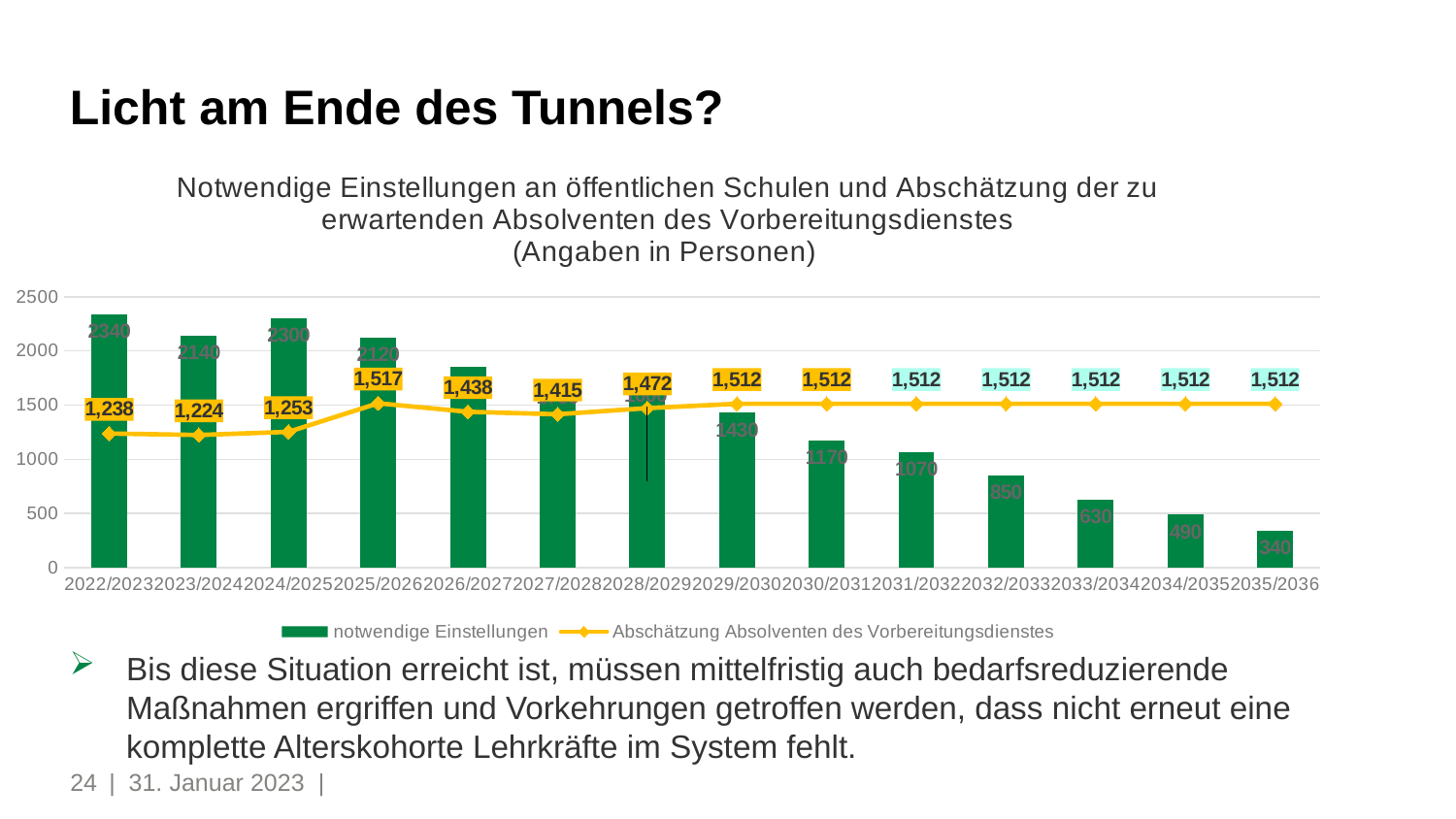
For 2029/2030, which is larger: notwendige Einstellungen or Abschätzung Absolventen des Vorbereitungsdienstes? Abschätzung Absolventen des Vorbereitungsdienstes What is the difference between notwendige Einstellungen in 2022/2023 and in 2035/2036? 2000 What is the value of Abschätzung Absolventen des Vorbereitungsdienstes for 2025/2026? 1,517 Is the value of notwendige Einstellungen for 2026/2027 greater or less than 1500? greater How many school years are shown on the x axis? 14 What kind of chart is shown on the slide? Combined bar and line chart Which school year has the lowest value for Abschätzung Absolventen des Vorbereitungsdienstes? 2023/2024 Do the values for notwendige Einstellungen generally rise or fall from 2022/2023 to 2035/2036? Fall How many series does the legend list? 2 Which school year has the highest value for notwendige Einstellungen? 2022/2023 What is the value of notwendige Einstellungen for 2022/2023? 2340 Which school year has the lowest value for notwendige Einstellungen? 2035/2036